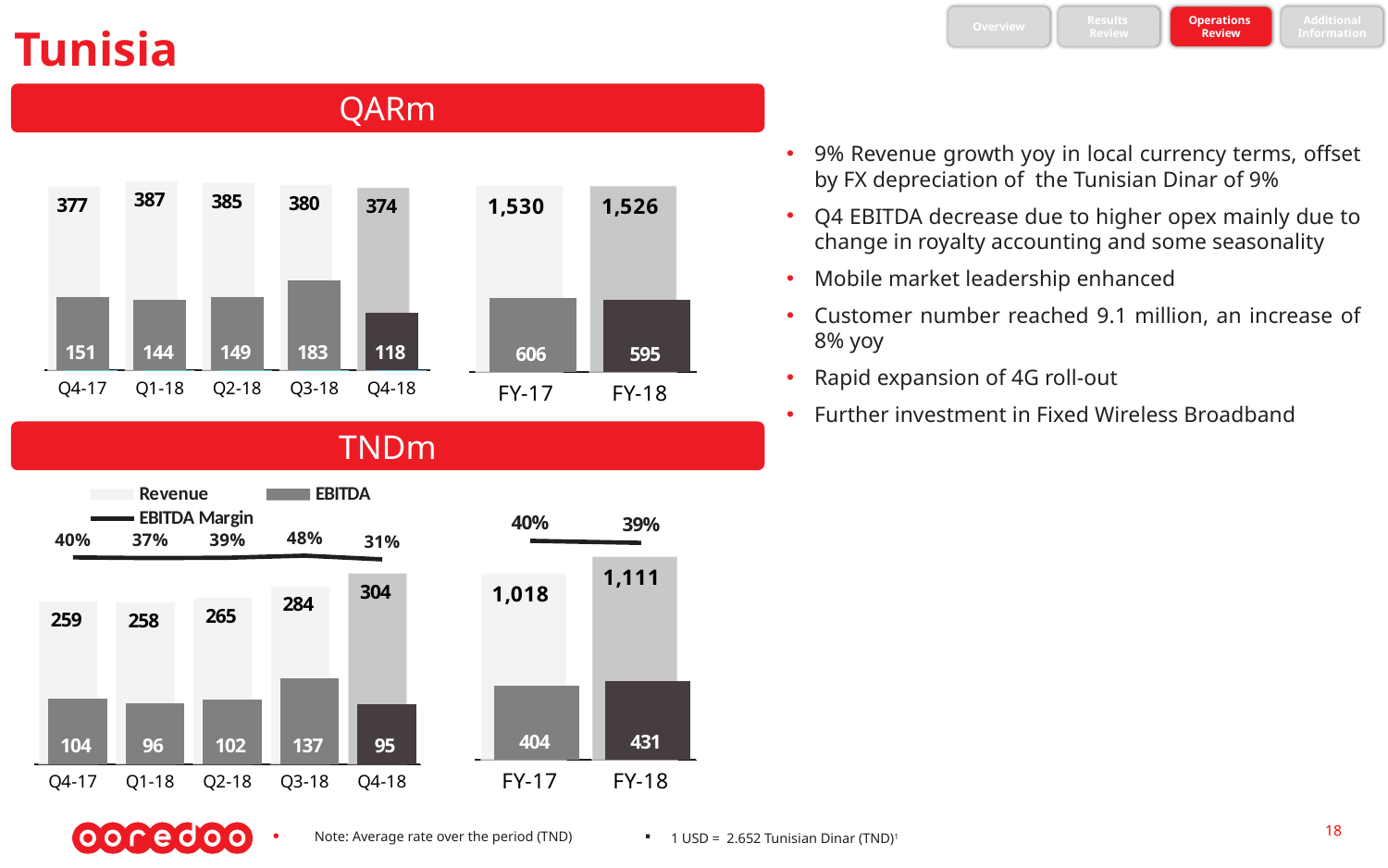
In the TNDm quarterly chart (bottom left), what is the difference in EBITDA between Q3-18 and Q4-18? 42 In the QARm full-year chart (top right), what is the difference between FY-17 and FY-18 revenue? 4 In the TNDm quarterly chart (bottom left), how many quarters are shown on the x axis? 5 How many series does the legend in the TNDm section list? 3 In the TNDm full-year chart (bottom right), is FY-18 revenue higher or lower than FY-17 revenue? higher In the QARm quarterly chart (top left), which quarter has the highest EBITDA? Q3-18 In the QARm quarterly chart (top left), which quarter has the lowest revenue? Q4-18 In the QARm quarterly chart (top left), what is the EBITDA for Q4-18? 118 In the QARm full-year chart (top right), what is the EBITDA for FY-18? 595 In the QARm quarterly chart (top left), what is the revenue for Q1-18? 387 In the TNDm quarterly chart (bottom left), what is the EBITDA margin for Q3-18? 48% In the TNDm quarterly chart (bottom left), which quarter has the lowest EBITDA margin? Q4-18